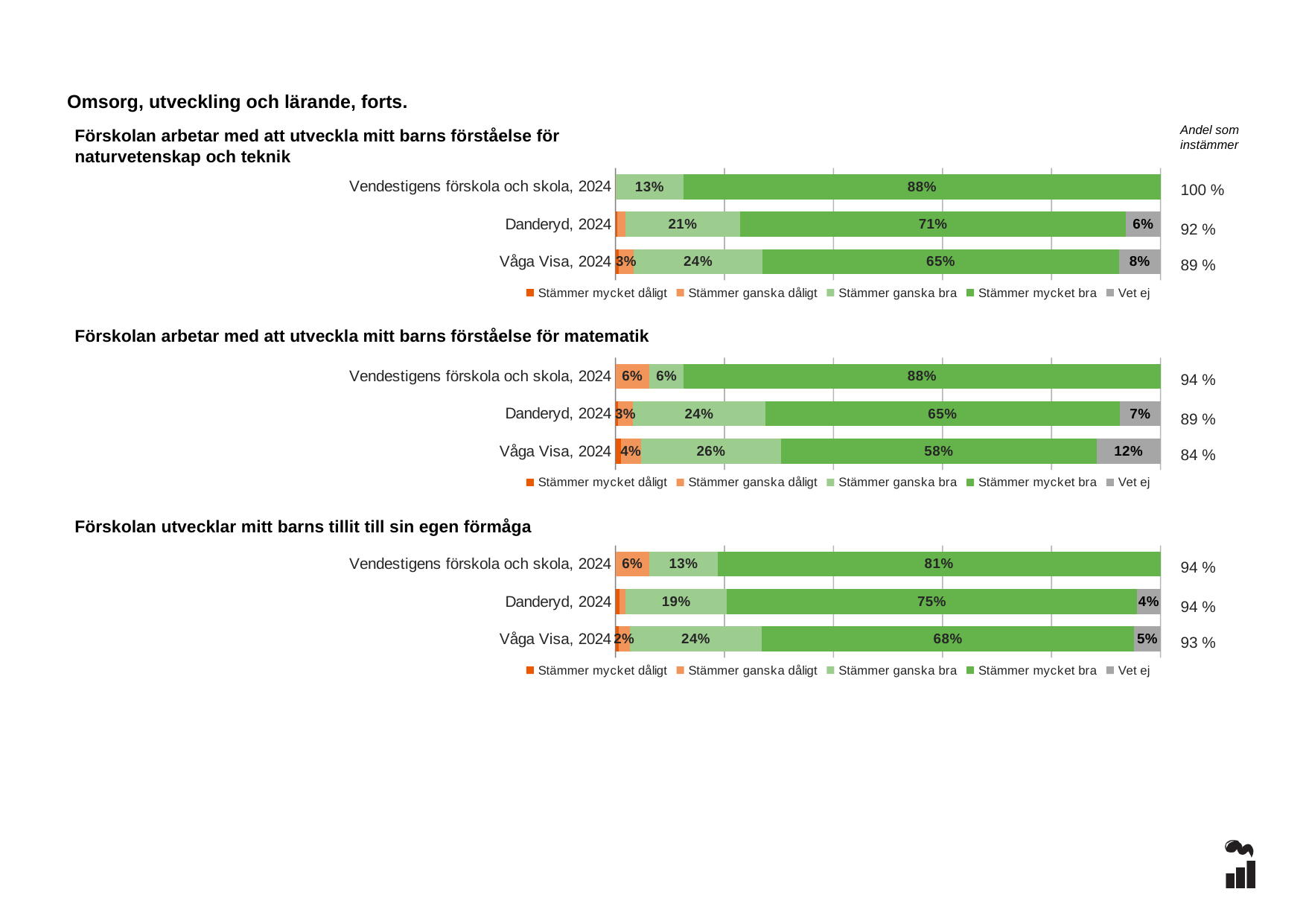
In the chart 'Förskolan utvecklar mitt barns tillit till sin egen förmåga', what is the 'Stämmer mycket bra' value for Danderyd, 2024? 75% In the chart 'Förskolan arbetar med att utveckla mitt barns förståelse för naturvetenskap och teknik', which row has the highest 'Andel som instämmer'? Vendestigens förskola och skola, 2024 In the chart 'Förskolan utvecklar mitt barns tillit till sin egen förmåga', what is the 'Andel som instämmer' for Våga Visa, 2024? 93 % In the chart 'Förskolan arbetar med att utveckla mitt barns förståelse för naturvetenskap och teknik', what is the 'Stämmer mycket bra' value for Vendestigens förskola och skola, 2024? 88% In the chart 'Förskolan arbetar med att utveckla mitt barns förståelse för matematik', which is larger: the 'Vet ej' value for Danderyd, 2024 or for Våga Visa, 2024? Våga Visa, 2024 In the chart 'Förskolan arbetar med att utveckla mitt barns förståelse för matematik', what is the 'Stämmer ganska bra' value for Våga Visa, 2024? 26% In the chart 'Förskolan arbetar med att utveckla mitt barns förståelse för matematik', which row has the lowest 'Andel som instämmer'? Våga Visa, 2024 How many series does the legend list for the chart 'Förskolan arbetar med att utveckla mitt barns förståelse för naturvetenskap och teknik'? 5 In the chart 'Förskolan arbetar med att utveckla mitt barns förståelse för naturvetenskap och teknik', what is the 'Vet ej' value for Våga Visa, 2024? 8% In the chart 'Förskolan arbetar med att utveckla mitt barns förståelse för matematik', what is the difference between the 'Stämmer mycket bra' values for Vendestigens förskola och skola, 2024 and Danderyd, 2024? 23% What kind of chart is 'Förskolan arbetar med att utveckla mitt barns förståelse för matematik'? Stacked bar chart How many rows (categories) are shown in the chart 'Förskolan utvecklar mitt barns tillit till sin egen förmåga'? 3